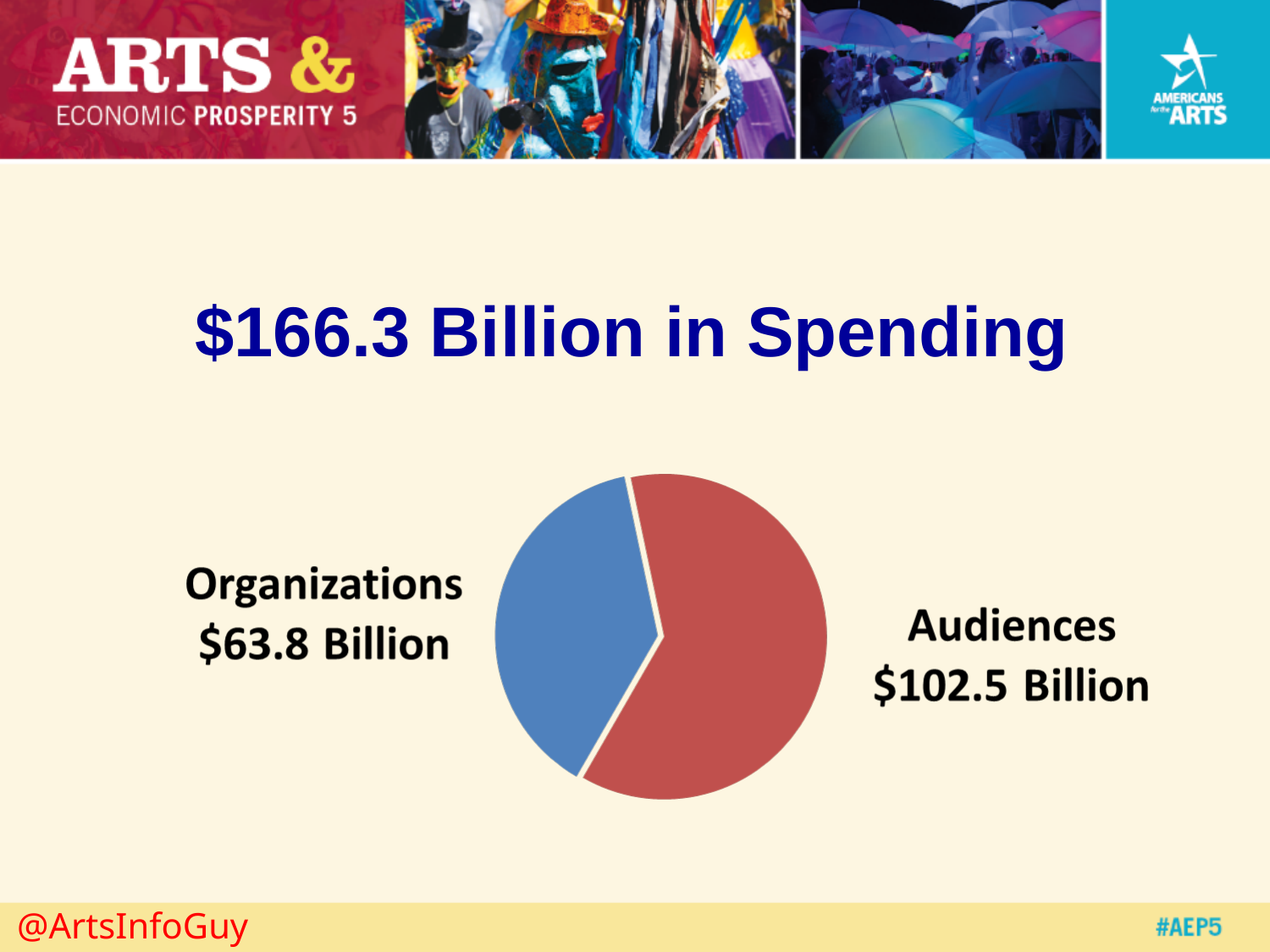
What colour is the Audiences slice of the pie chart? Red What is the difference between Audiences spending and Organizations spending? $38.7 Billion Which slice of the pie chart is the smallest? Organizations What kind of chart is shown on the slide? Pie chart What colour is the Organizations slice of the pie chart? Blue What is the total spending shown in the slide title? $166.3 Billion How many slices does the pie chart have? 2 What is the spending value for Organizations in the pie chart? $63.8 Billion Which is larger, spending by Organizations or spending by Audiences? Audiences Which slice of the pie chart is the largest? Audiences What share of the total $166.3 Billion spending comes from Audiences? 61.6% What is the spending value for Audiences in the pie chart? $102.5 Billion